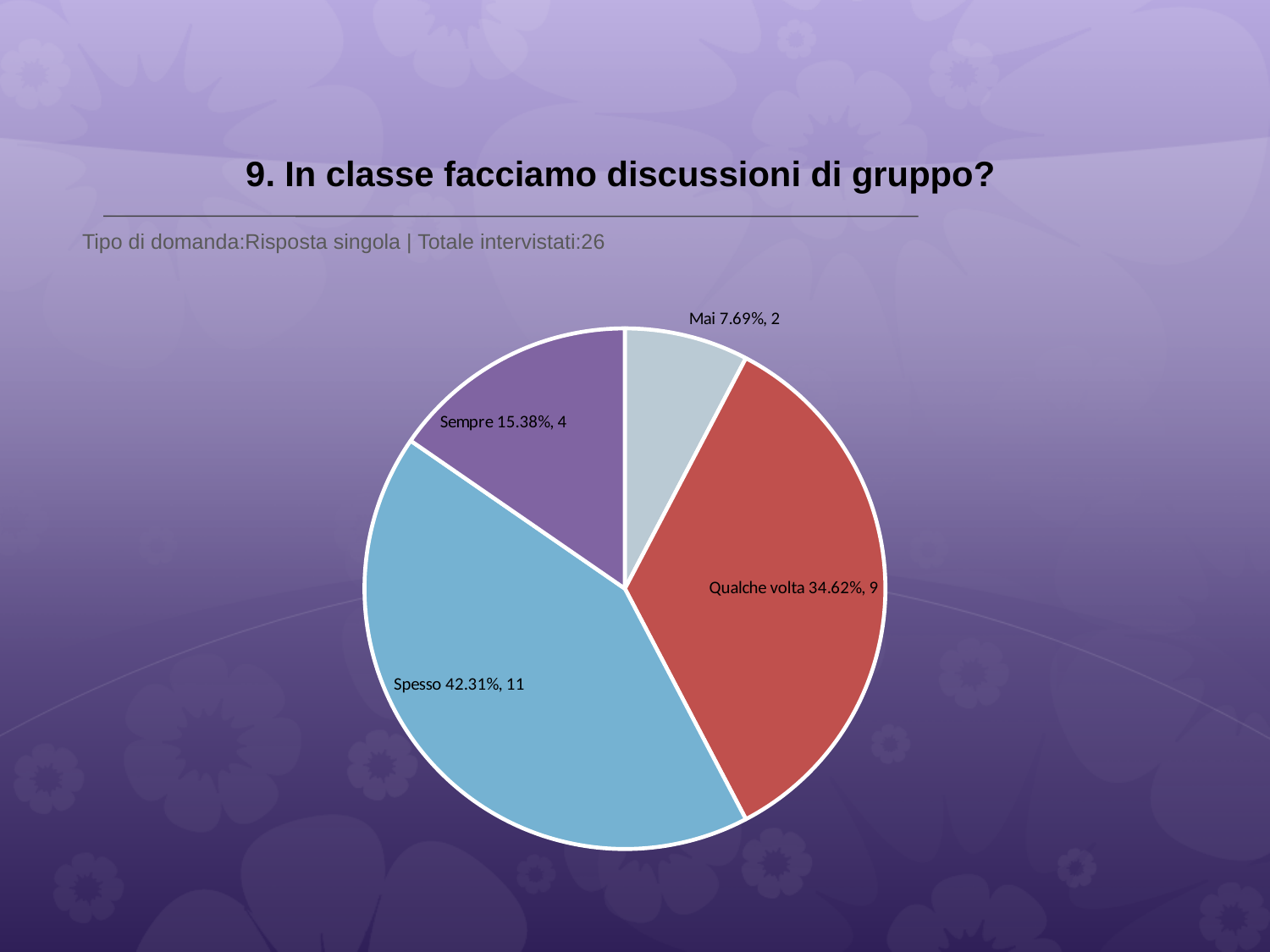
How many respondents answered 'Qualche volta'? 9 What percentage share does the 'Sempre' slice have? 15.38% Which category has the smallest slice? Mai How many slices does the pie chart have? 4 Which has more respondents, 'Sempre' or 'Mai'? Sempre What percentage share does the 'Spesso' slice have? 42.31% What is the title of the chart on the slide? 9. In classe facciamo discussioni di gruppo? What kind of chart is shown on the slide? pie chart What is the total number of respondents across all slices? 26 What is the difference in respondent count between 'Spesso' and 'Qualche volta'? 2 Which category has the largest slice? Spesso How many respondents answered 'Mai'? 2